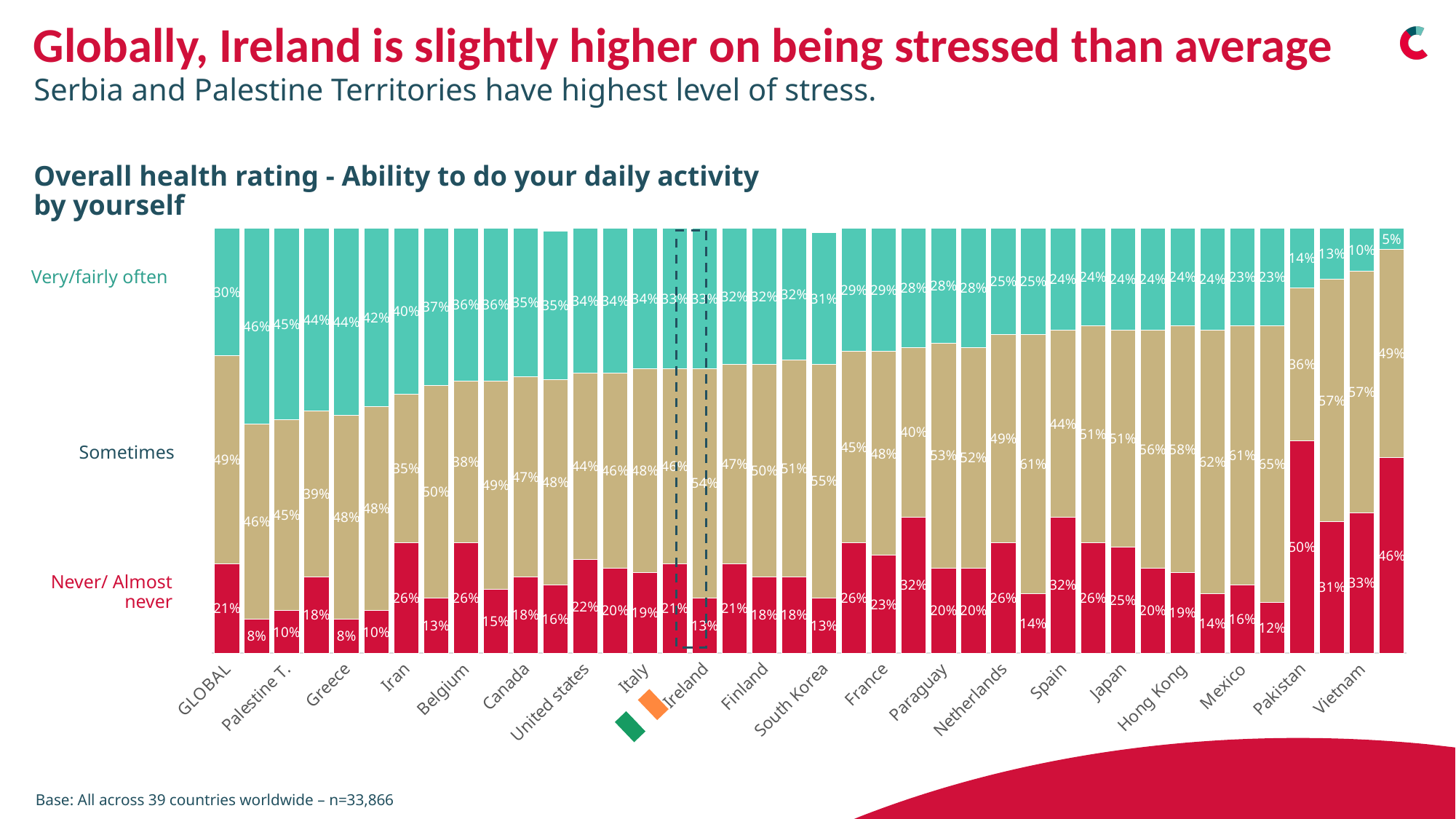
Which has a higher Never/Almost never value, Pakistan or Vietnam? Pakistan What is the Sometimes value for South Korea? 55% Which country's bar is highlighted with a dashed outline? Ireland What is the Never/Almost never value for Spain? 32% What percentage of respondents in Ireland say they feel stressed very/fairly often? 33% What is the Never/Almost never value for Greece? 8% By how many percentage points does Ireland's Very/fairly often value exceed the GLOBAL value? 3 percentage points What kind of chart is shown on the slide? Stacked bar chart What is the Never/Almost never value for Pakistan? 50% What is the GLOBAL value for Never/Almost never? 21% What is the Sometimes value for Ireland? 54% How many response categories (series) are stacked in each bar? 3